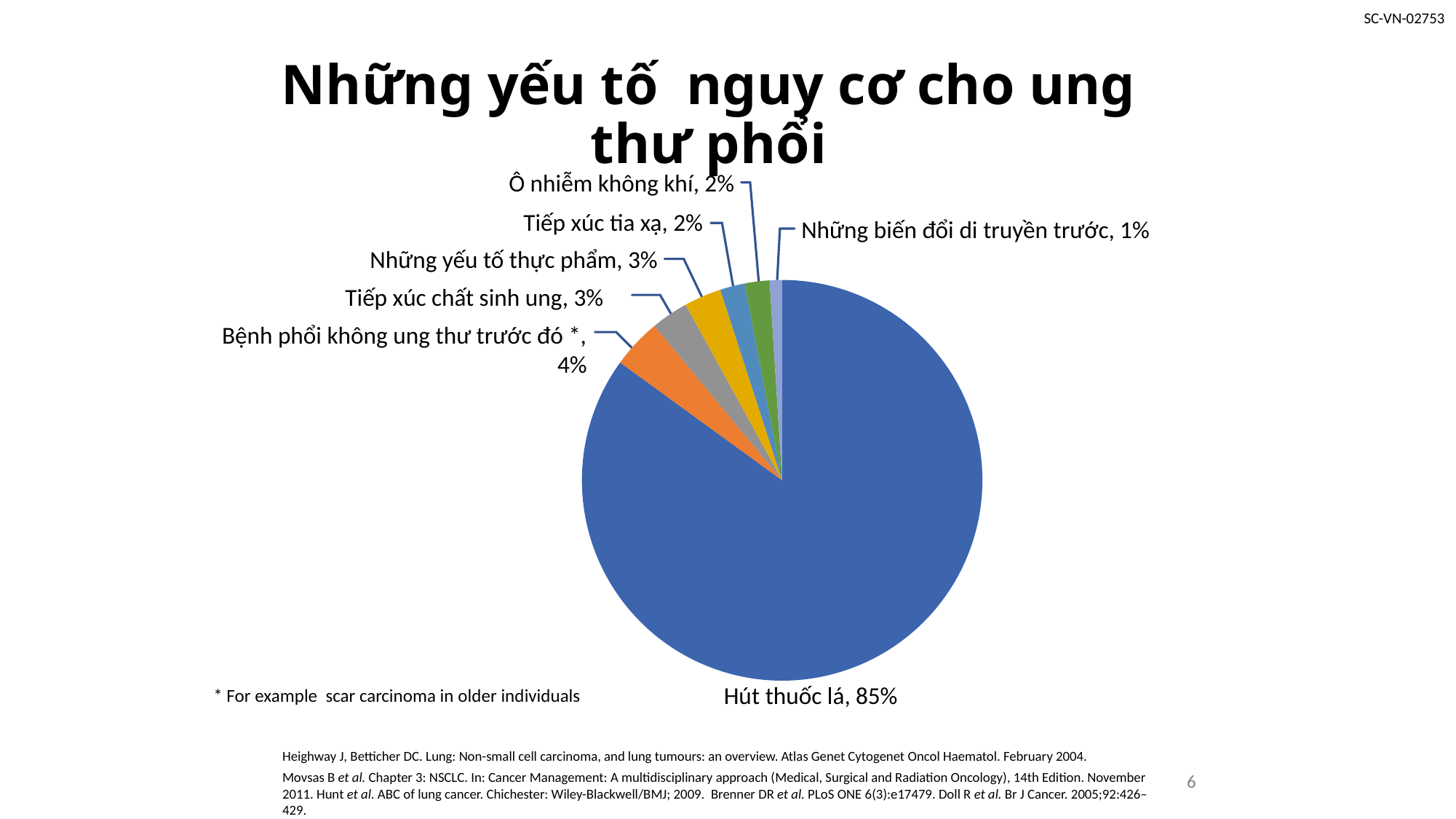
What is the value shown for Tiếp xúc chất sinh ung? 3% What is the value shown for Những biến đổi di truyền trước? 1% Which is larger, the value for Bệnh phổi không ung thư trước đó * or the value for Tiếp xúc tia xạ? Bệnh phổi không ung thư trước đó * How many slices does the pie chart have? 7 Which category has the largest slice of the pie? Hút thuốc lá What is the difference between the values for Hút thuốc lá and Bệnh phổi không ung thư trước đó *? 81% What colour is the slice for Hút thuốc lá? blue What is the value shown for Ô nhiễm không khí? 2% What kind of chart is shown on the slide? pie chart What is the value shown for Bệnh phổi không ung thư trước đó *? 4% Which category has the smallest slice of the pie? Những biến đổi di truyền trước What share of the pie does Hút thuốc lá account for? 85%